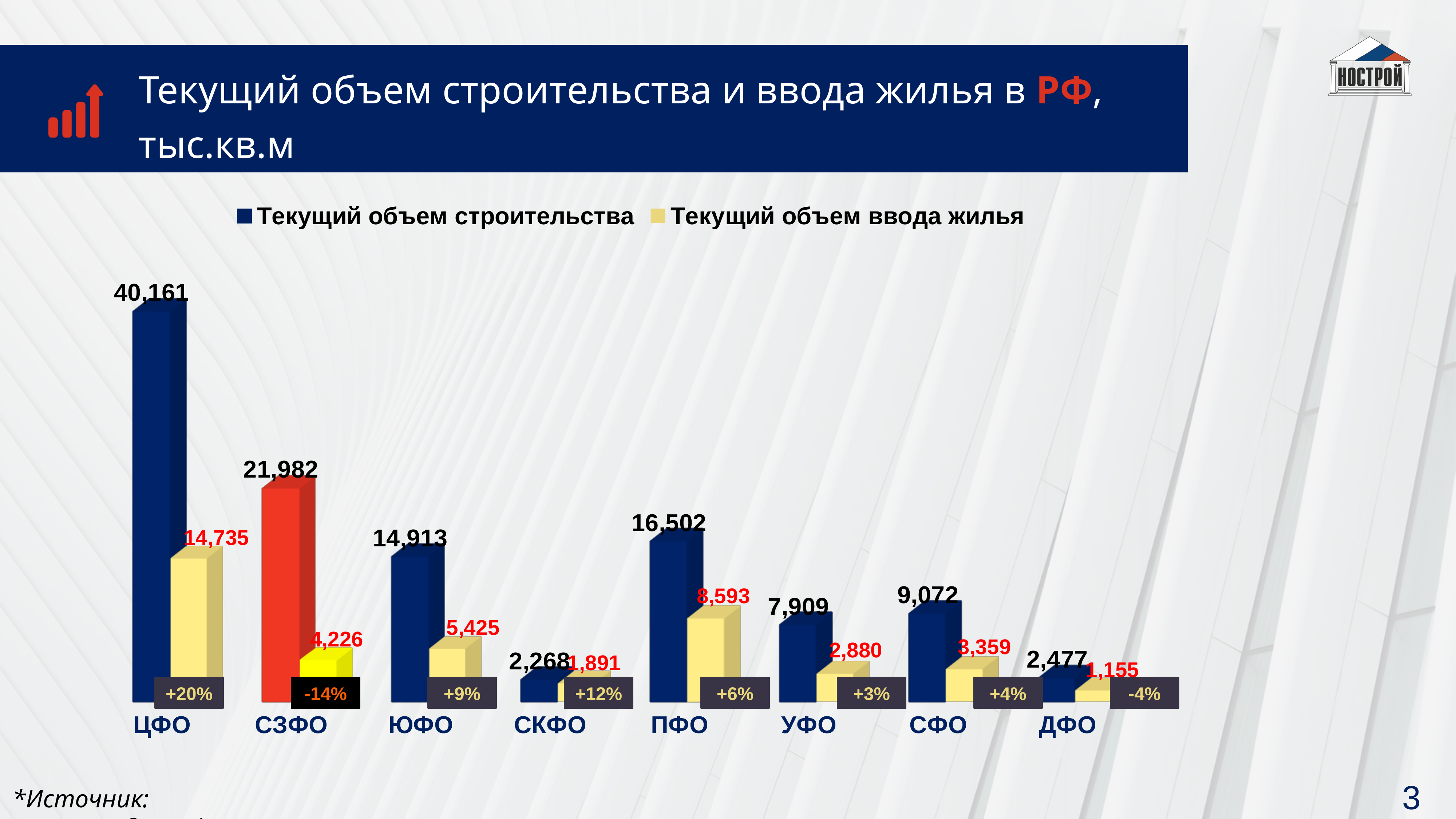
What is the value of "Текущий объем ввода жилья" for ПФО? 8,593 Which region has the lowest value of "Текущий объем ввода жилья"? ДФО What percentage change is shown in the label under the СЗФО bars? -14% How many regions are shown on the x axis? 8 What is the value of "Текущий объем ввода жилья" for ДФО? 1,155 How many series does the legend list? 2 What is the value of "Текущий объем строительства" for ЦФО? 40,161 What kind of chart is shown on the slide? Bar chart Which region has the highest value of "Текущий объем строительства"? ЦФО What is the difference between "Текущий объем строительства" and "Текущий объем ввода жилья" for ЮФО? 9,488 Which is larger: "Текущий объем строительства" for ПФО or for СФО? ПФО What is the value of "Текущий объем строительства" for СЗФО? 21,982